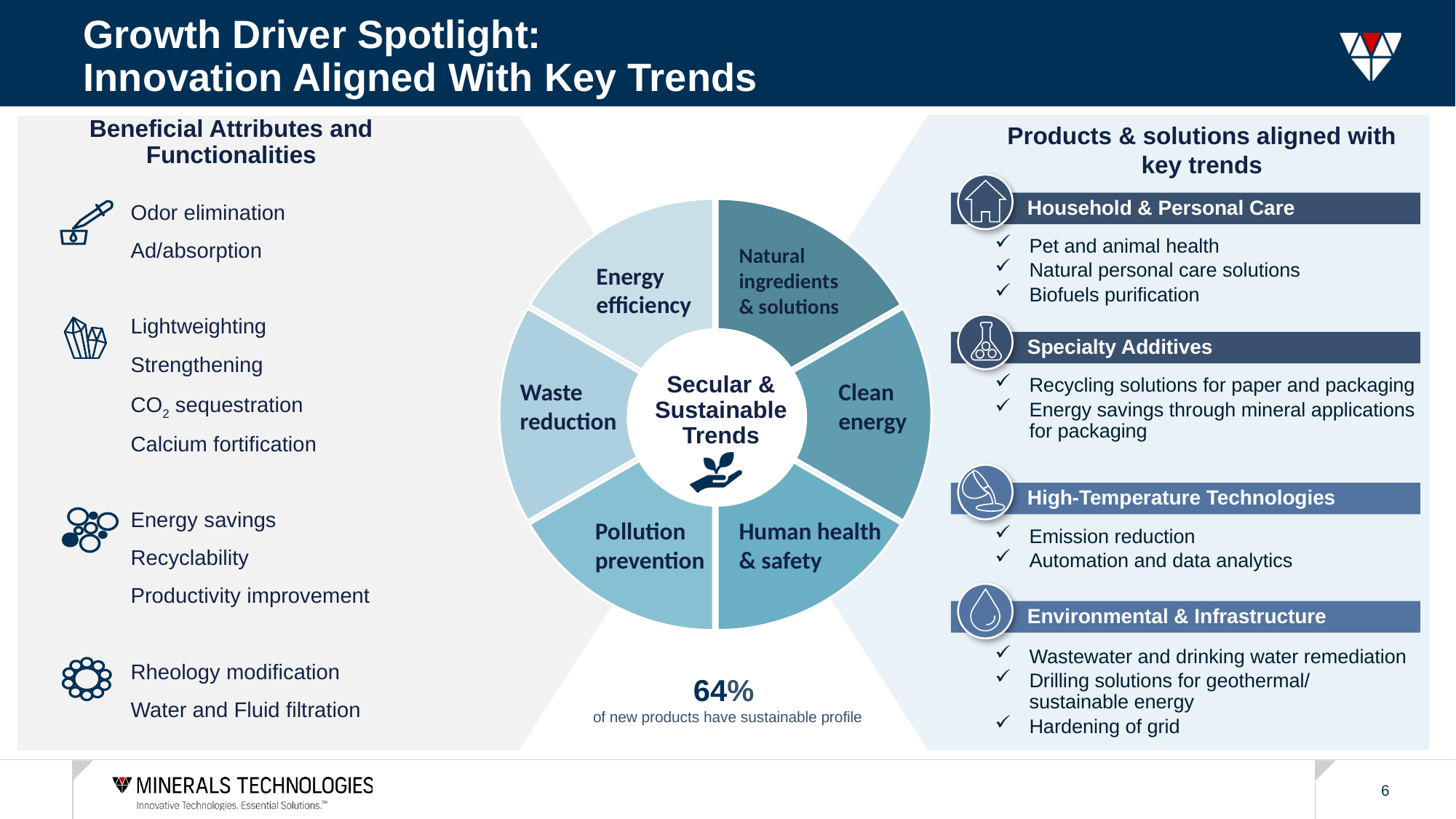
According to the text below the circular diagram, what percentage of new products have a sustainable profile? 64% Which segment of the circular diagram sits directly to the right of the centre label? Clean energy How many segments does the circular diagram in the centre of the slide have? 6 What text appears in the centre of the circular diagram? Secular & Sustainable Trends What kind of chart is the circular diagram in the centre of the slide? Donut (ring) diagram